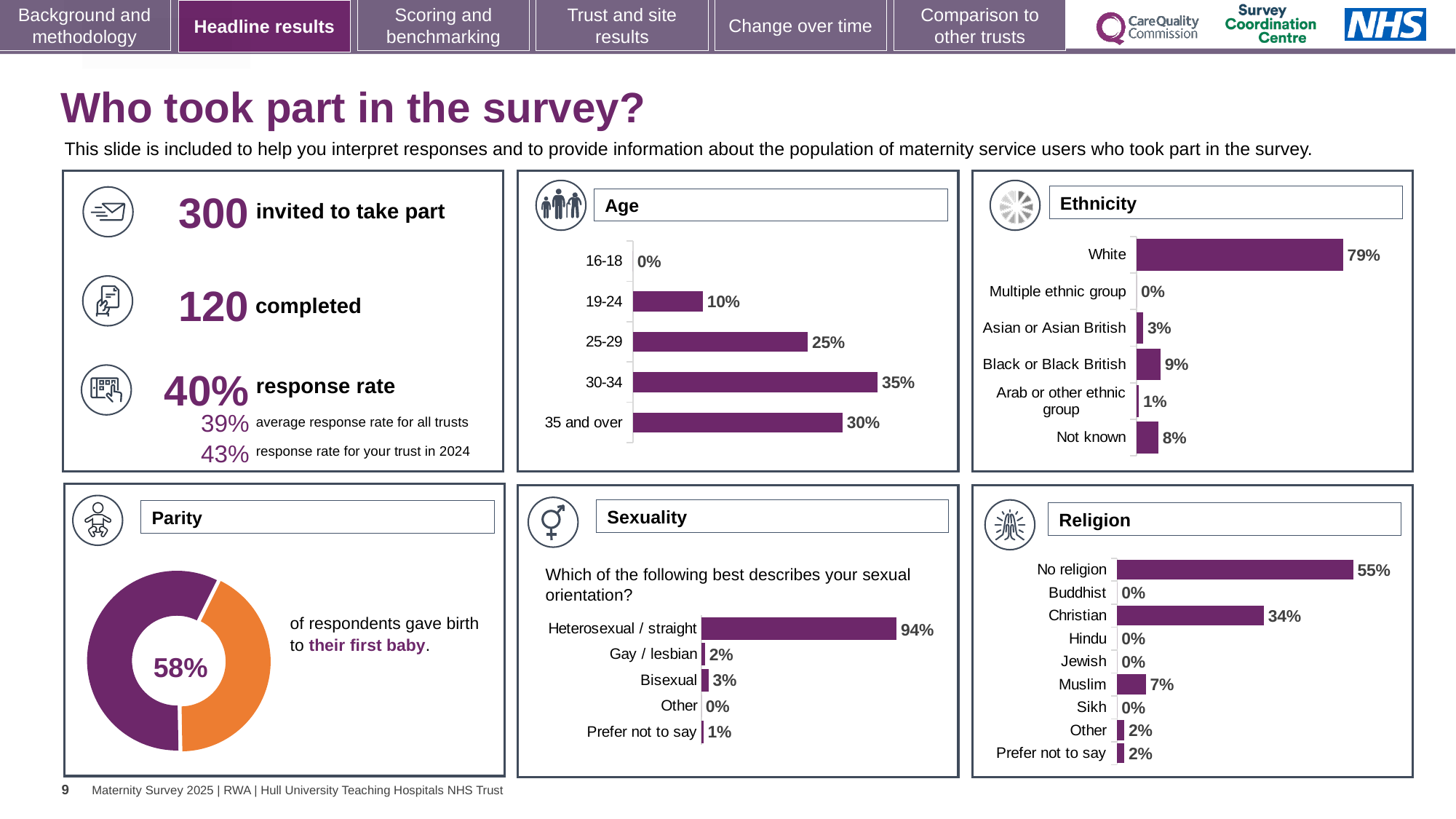
What kind of chart is the Parity chart? Doughnut chart In the Sexuality chart, what percentage of respondents answered Bisexual? 3% In the Religion chart, what percentage of respondents were Christian? 34% In the Ethnicity chart, what percentage of respondents were White? 79% In the Parity chart, what percentage of respondents gave birth to their first baby? 58% In the Age chart, which age group has the highest percentage? 30-34 In the Sexuality chart, how many response categories are shown? 5 In the Age chart, how many age categories are shown? 5 In the Ethnicity chart, what is the difference between the Black or Black British and Asian or Asian British percentages? 6% In the Ethnicity chart, which is larger: Not known or Black or Black British? Black or Black British In the Age chart, what percentage of respondents were aged 30-34? 35% In the Religion chart, what is the difference between No religion and Christian? 21%